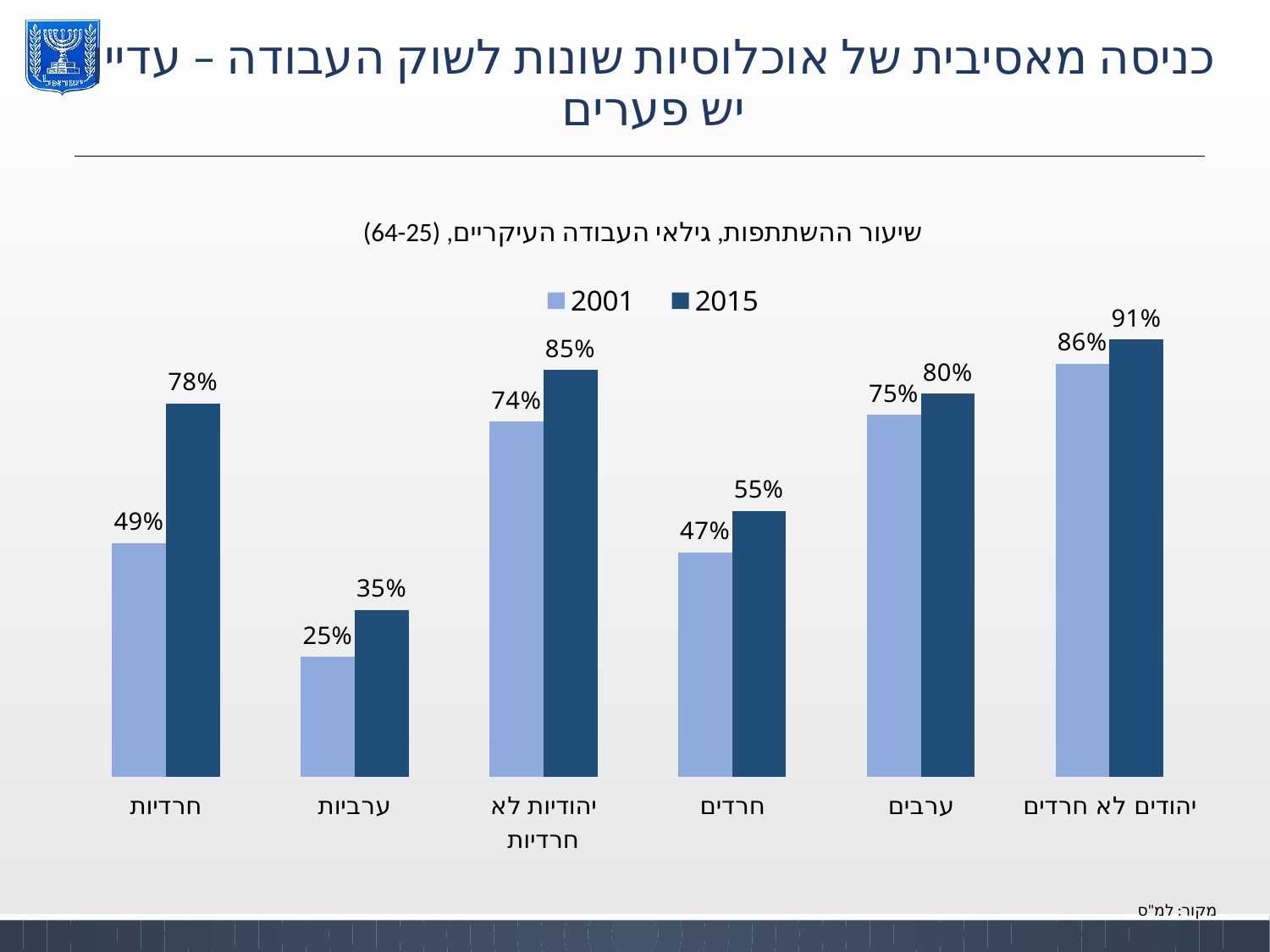
Which category has the lowest 2001 value? ערביות How many categories are shown on the x axis? 6 Which is larger: the 2001 value for יהודיות לא חרדיות or the 2001 value for ערבים? ערבים What is the 2001 value for ערביות? 25% What is the difference between the 2015 and 2001 values for ערבים? 5% What is the 2015 value for יהודים לא חרדים? 91% What is the 2001 value for חרדים? 47% What is the 2015 value for חרדיות? 78% Which category has the highest 2015 value? יהודים לא חרדים What kind of chart is shown on the slide? bar chart What is the difference between the 2015 and 2001 values for חרדיות? 29% How many series does the legend list? 2